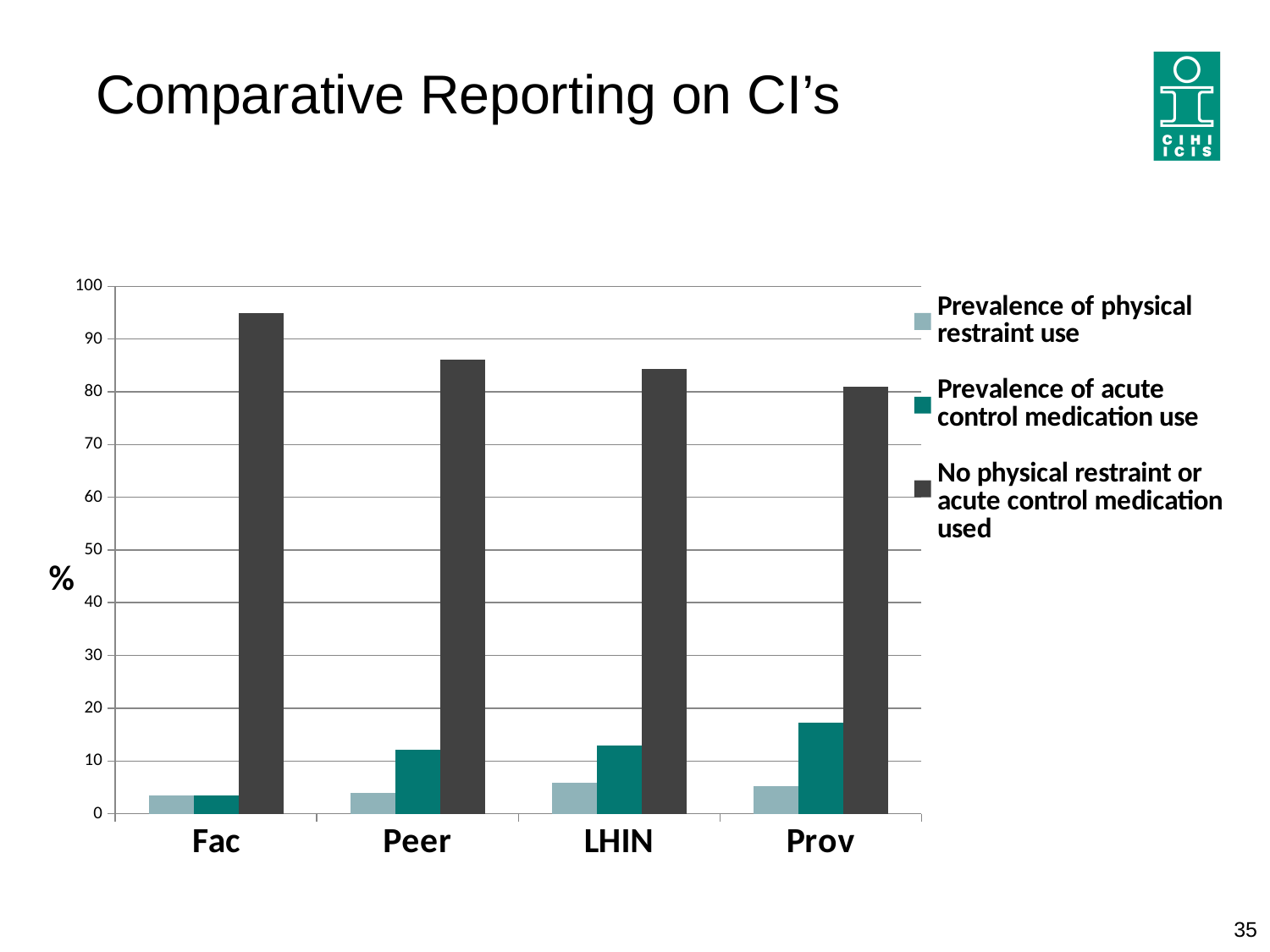
What kind of chart is shown on the slide? bar chart Is the value for 'Prevalence of acute control medication use' for Peer greater or less than 10? greater Does the value for 'No physical restraint or acute control medication used' rise or fall from Fac to Prov along the x axis? fall Is the value for 'No physical restraint or acute control medication used' for Fac greater or less than 90? greater Which category has the lowest value for 'Prevalence of acute control medication use'? Fac How many categories are shown on the x axis of the chart? 4 Which category has the highest value for 'No physical restraint or acute control medication used'? Fac Which category has the lowest value for 'No physical restraint or acute control medication used'? Prov Which is larger: 'Prevalence of acute control medication use' for Prov or for LHIN? Prov Is the value for 'Prevalence of physical restraint use' for LHIN greater or less than 10? less How many series does the chart's legend list? 3 Which category has the highest value for 'Prevalence of acute control medication use'? Prov